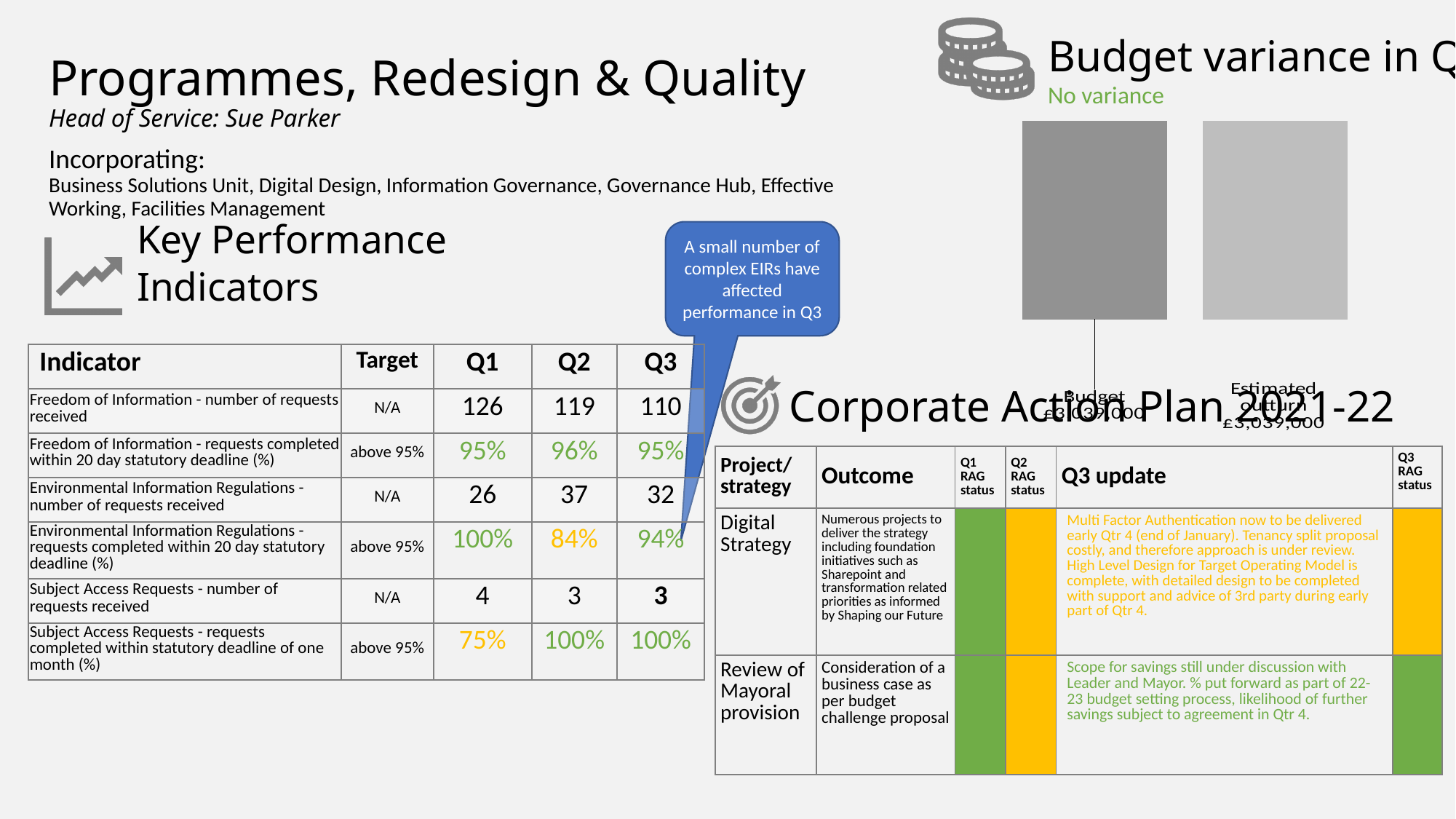
What is the difference between the Budget and Estimated Outturn values in the budget variance chart? £0 In the budget variance chart, is the Budget bar taller or shorter than the Estimated Outturn bar, or are they the same height? The same height What text appears in green directly beneath the 'Budget variance' heading above the chart? No variance What are the two category labels on the budget variance chart? Budget and Estimated Outturn What kind of chart is shown under the 'Budget variance' heading? Bar chart How many bars does the budget variance chart show? 2 In the budget variance chart, what is the value labelled for Estimated Outturn? £3,039,000 In the budget variance chart, what is the value labelled for Budget? £3,039,000